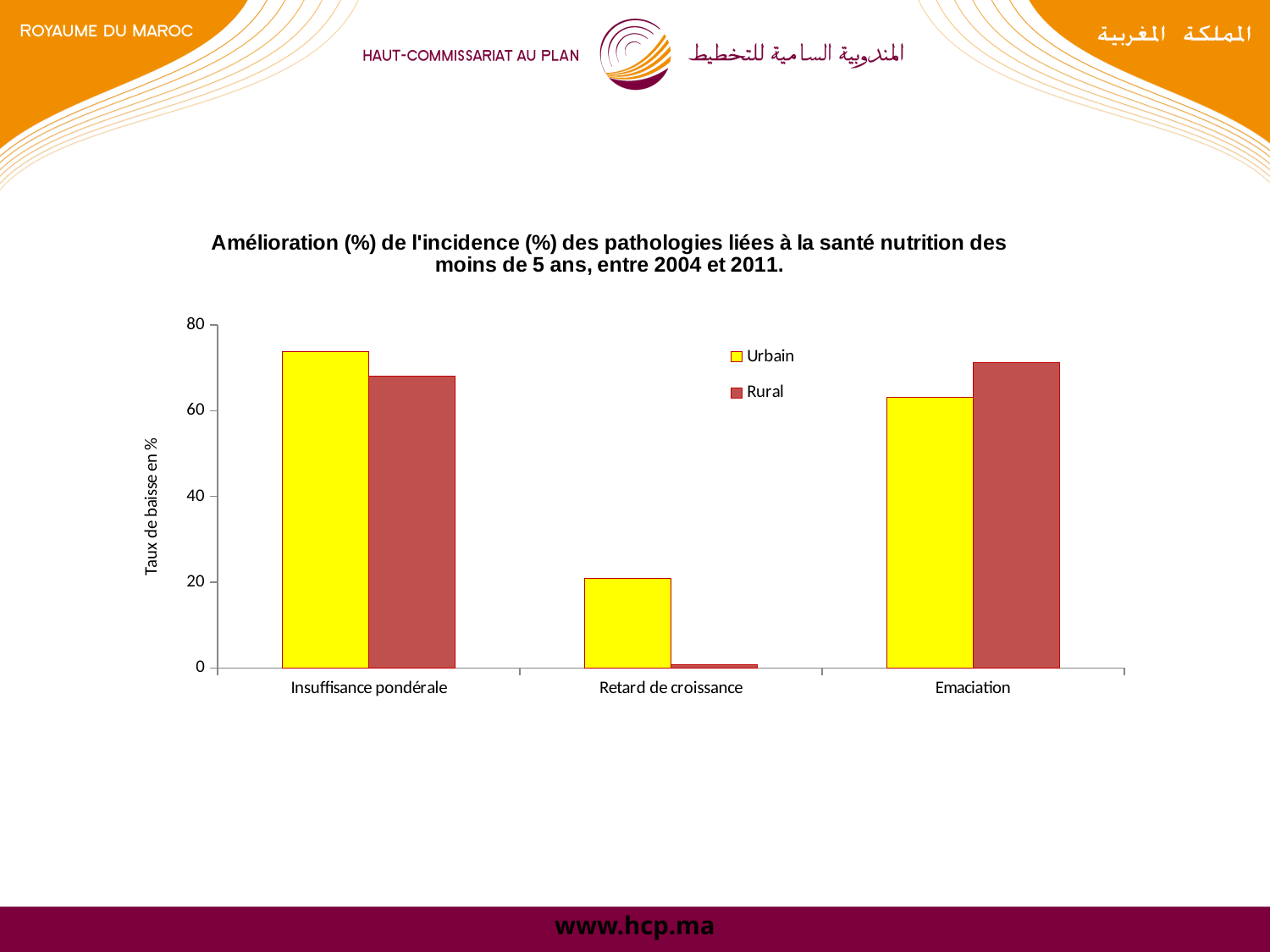
Which category has the lowest Urbain value? Retard de croissance What is the label of the y axis? Taux de baisse en % Is the Urbain value for Retard de croissance greater or less than 40? less Which category has the highest Urbain value? Insuffisance pondérale What kind of chart is shown on the slide? bar chart For Emaciation, which series has the larger value, Urbain or Rural? Rural For Insuffisance pondérale, which series has the larger value, Urbain or Rural? Urbain Which colour represents the Urbain series in the legend? yellow How many series does the legend list? 2 Which category has the lowest Rural value? Retard de croissance Is the Rural value for Emaciation greater or less than 60? greater How many categories are shown on the x axis? 3